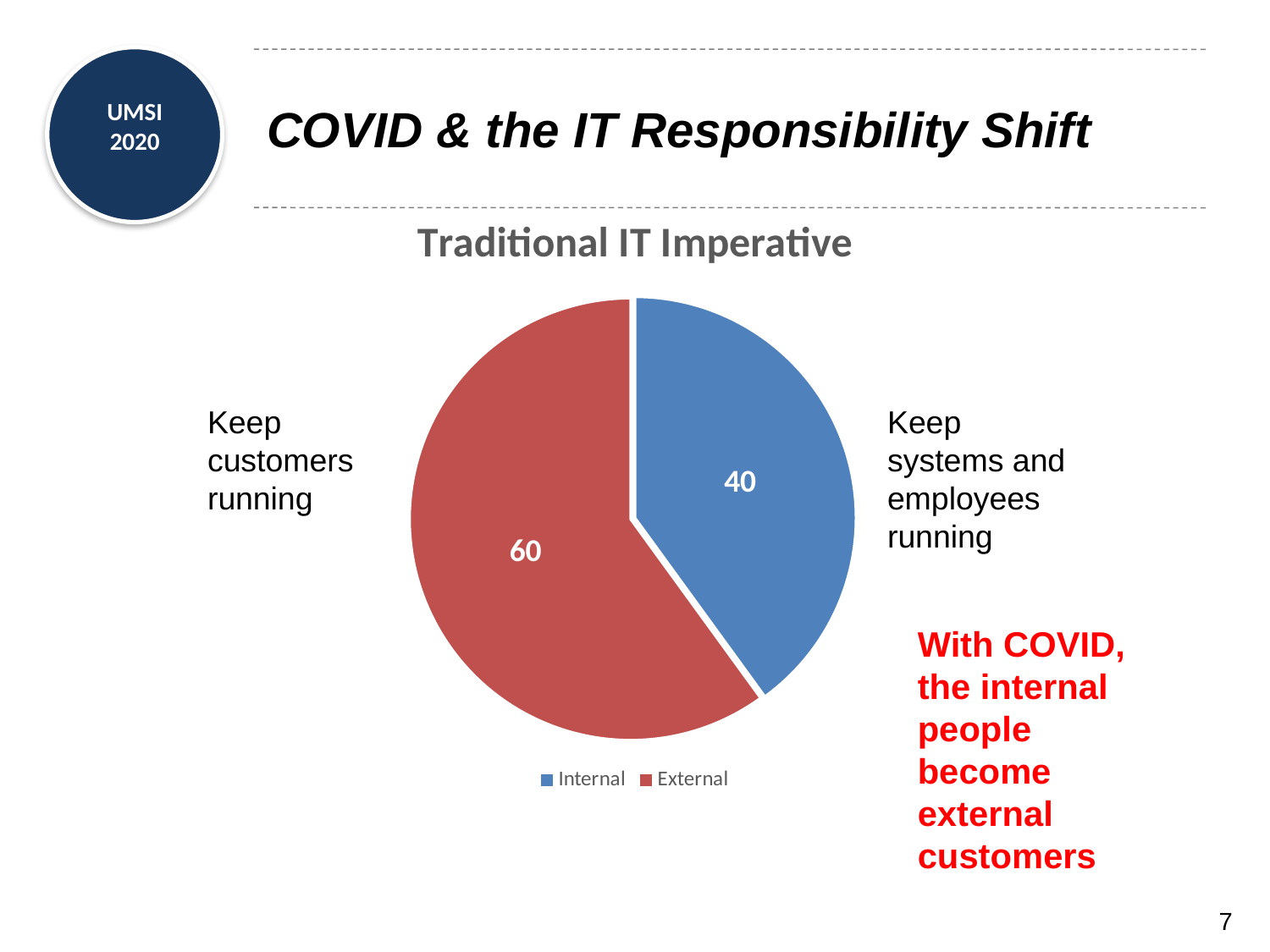
Which slice of the pie chart is the largest? External What is the value for External in the pie chart? 60 What is the difference between the External and Internal values? 20 How many slices does the pie chart have? 2 What colour is the Internal slice in the pie chart? Blue What share of the pie does the Internal slice represent? 40% What kind of chart is shown on the slide? Pie chart Which slice of the pie chart is the smallest? Internal What is the title of the chart? Traditional IT Imperative Which is larger, Internal or External? External What share of the pie does the External slice represent? 60% What is the value for Internal in the pie chart? 40